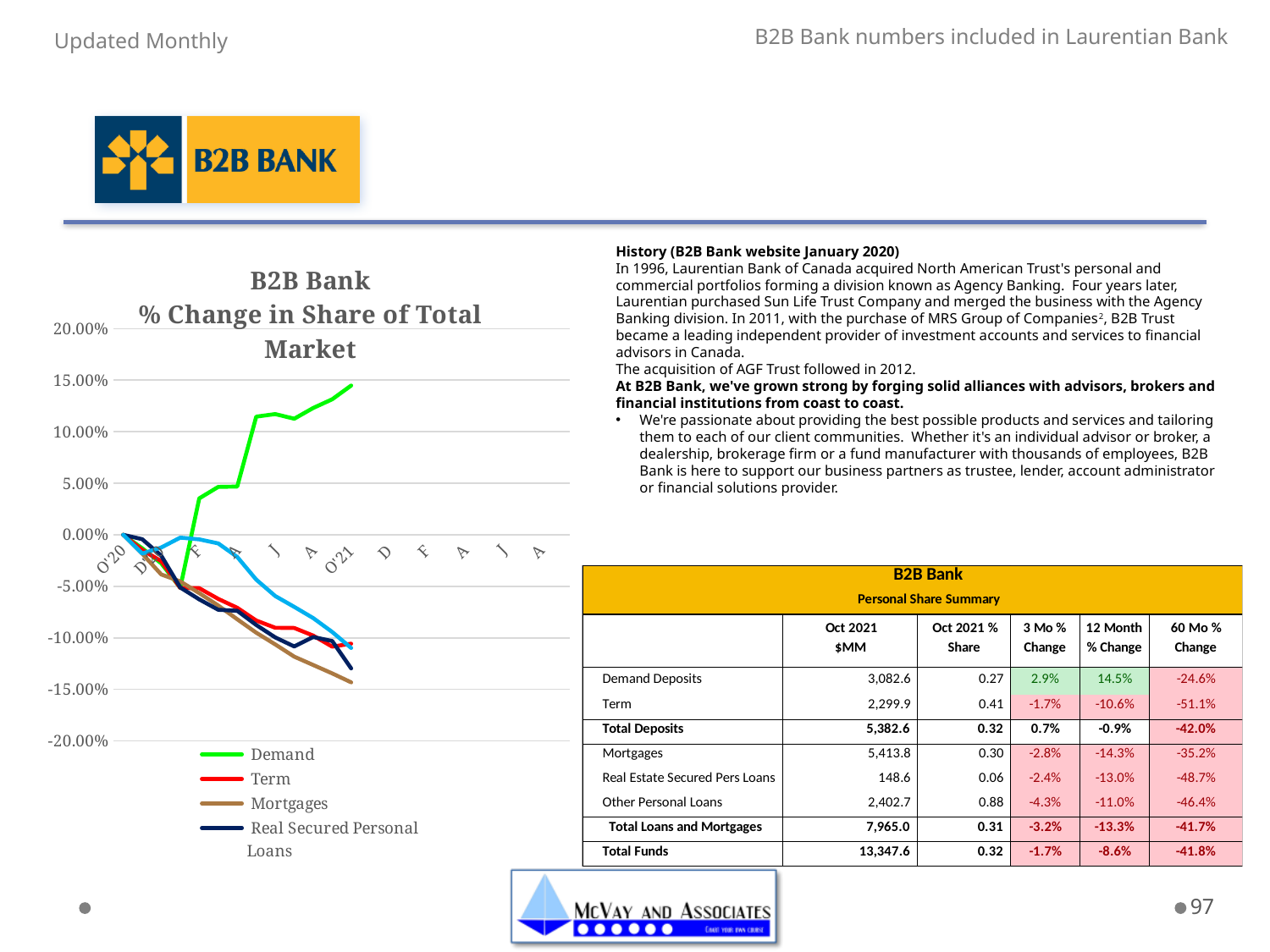
Which series has the lowest value at the end of the plotted period? Mortgages Which series has the highest value at the end of the plotted period? Demand What kind of chart is shown on the slide? line chart At the end of the plotted period, is the value for Mortgages greater or less than -10.00%? less Which colour is used for the Demand series in the chart? green What is the highest value shown on the chart's vertical axis? 20.00% What is the title of the chart? B2B Bank % Change in Share of Total Market At the end of the plotted period, is the value for Demand greater or less than 10.00%? greater Does the Mortgages series rise or fall over the period shown? fall Does the Demand series rise or fall over the period shown? rise How many series does the chart legend list? 4 At the end of the plotted period, which is larger, the value for Demand or the value for Term? Demand